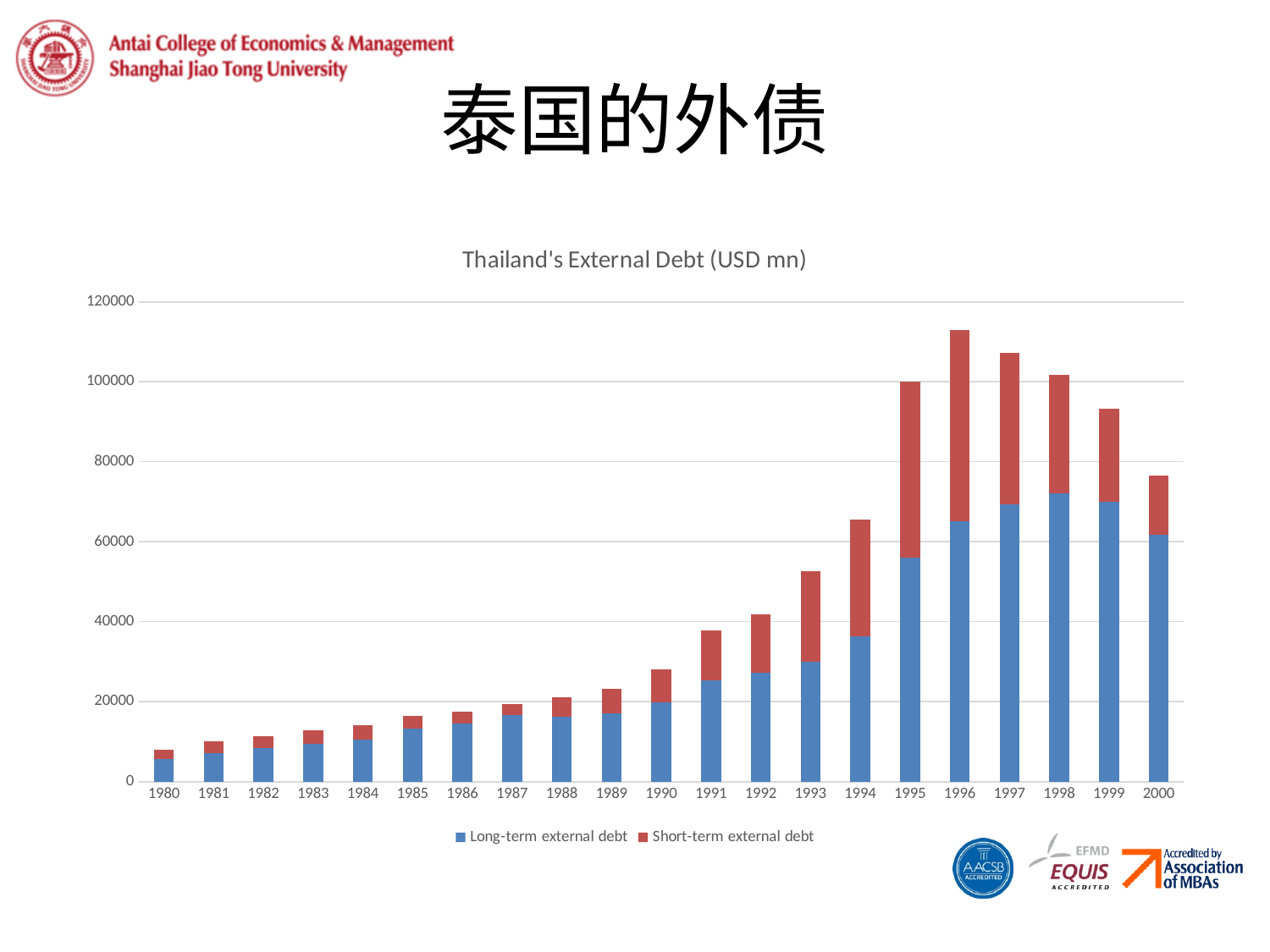
How many years are shown on the x axis of the chart? 21 Is the total external debt for 1999 greater or less than 100000? less Which year has the lowest total external debt? 1980 Does total external debt rise or fall from 1980 to 1996? rise What is the title of the chart? Thailand's External Debt (USD mn) What kind of chart is shown on the slide? Stacked bar chart Is the total external debt for 1996 greater or less than 100000? greater Which series is shown in red in the chart? Short-term external debt Is the long-term external debt for 1998 greater or less than 60000? greater Which year has the highest total external debt? 1996 How many series does the legend list? 2 Which year has the larger total external debt, 1999 or 2000? 1999